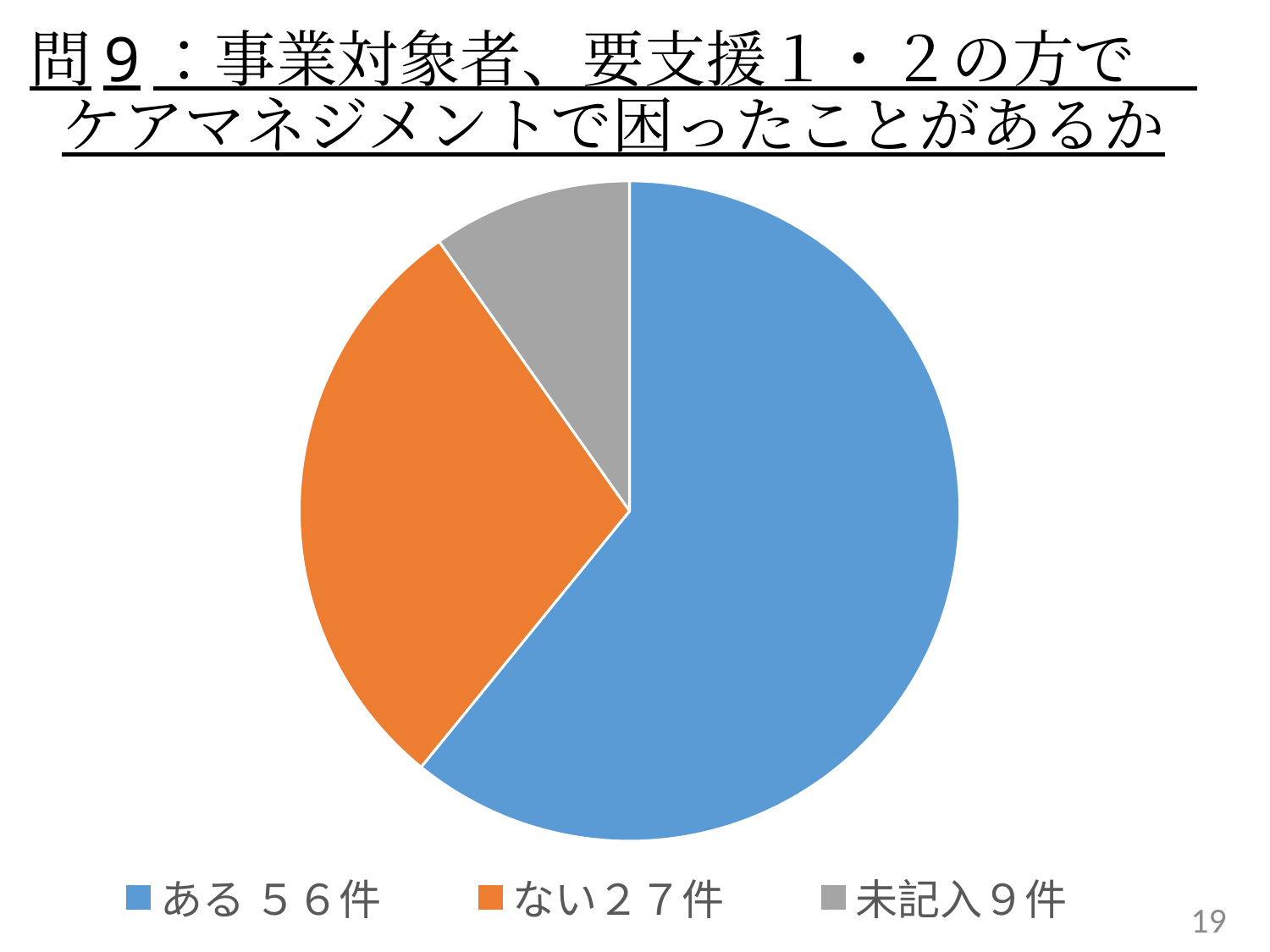
Which category has the smallest slice of the pie? 未記入 How many cases are recorded for 未記入 (not filled in) in the legend? ９件 How many cases are recorded for ある (yes) in the legend? ５６件 How many cases are recorded for ない (no) in the legend? ２７件 Which has more cases, ない or 未記入? ない What is the total number of cases across all three categories? 92件 What is the difference in the number of cases between ない and 未記入? 18件 What is the difference in the number of cases between ある and ない? 29件 Which category has the largest slice of the pie? ある How many categories does the pie chart have? 3 What colour is the slice for ある? blue What kind of chart is shown on the slide? pie chart